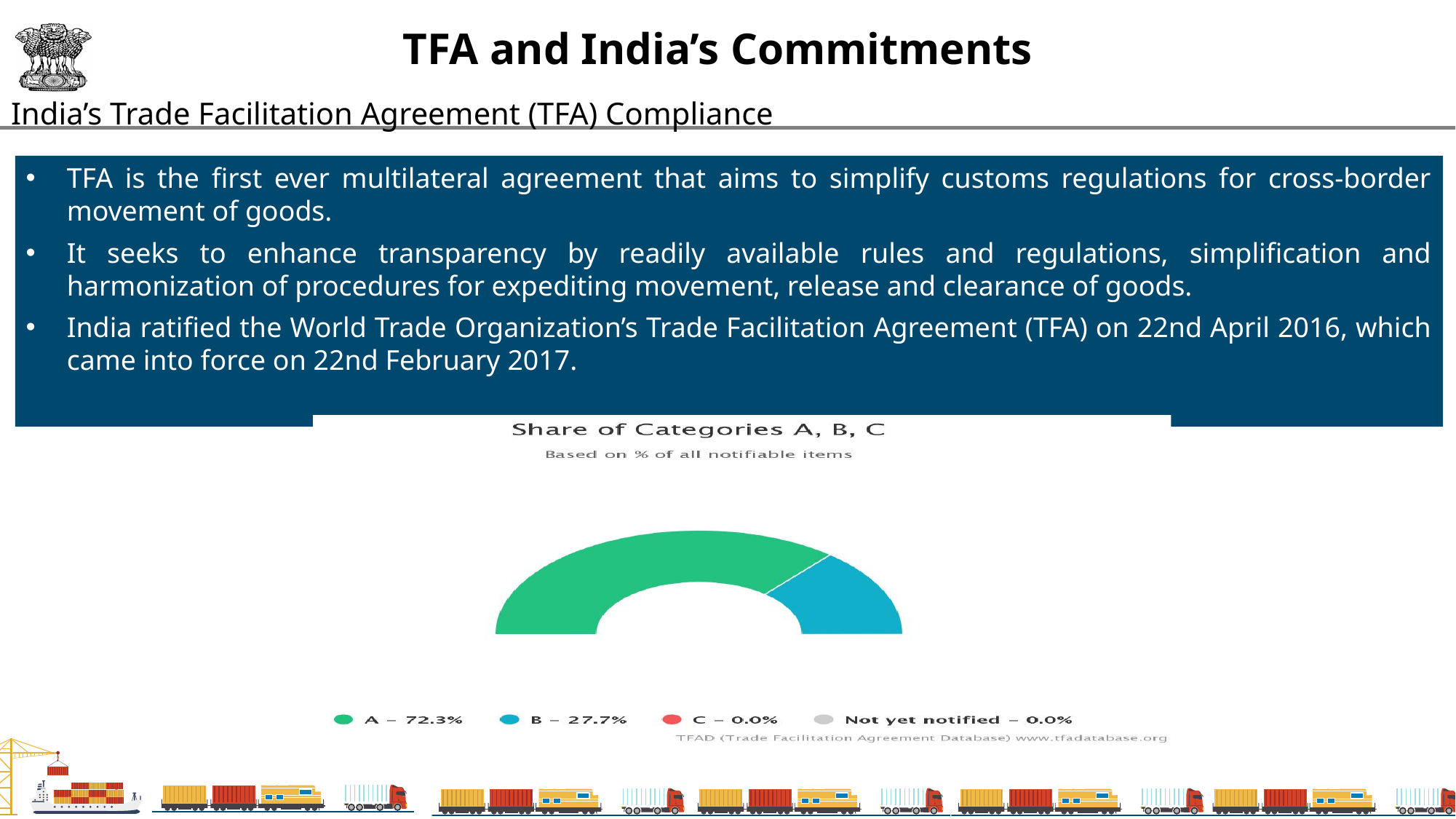
What is the difference between the shares of Category A and Category B? 44.6% What share does Category A have in the chart? 72.3% What share does Category C have in the chart? 0.0% How many entries does the chart's legend list? 4 What is the combined share of Categories A and B in the chart? 100.0% Which is larger, the share of Category A or Category B? A What kind of chart is shown on the slide? Donut (pie) chart What share is shown for 'Not yet notified' in the chart? 0.0% What share does Category B have in the chart? 27.7% What is the title of the chart on the slide? Share of Categories A, B, C What colour represents Category B in the chart? Blue Which category has the largest share in the chart? A